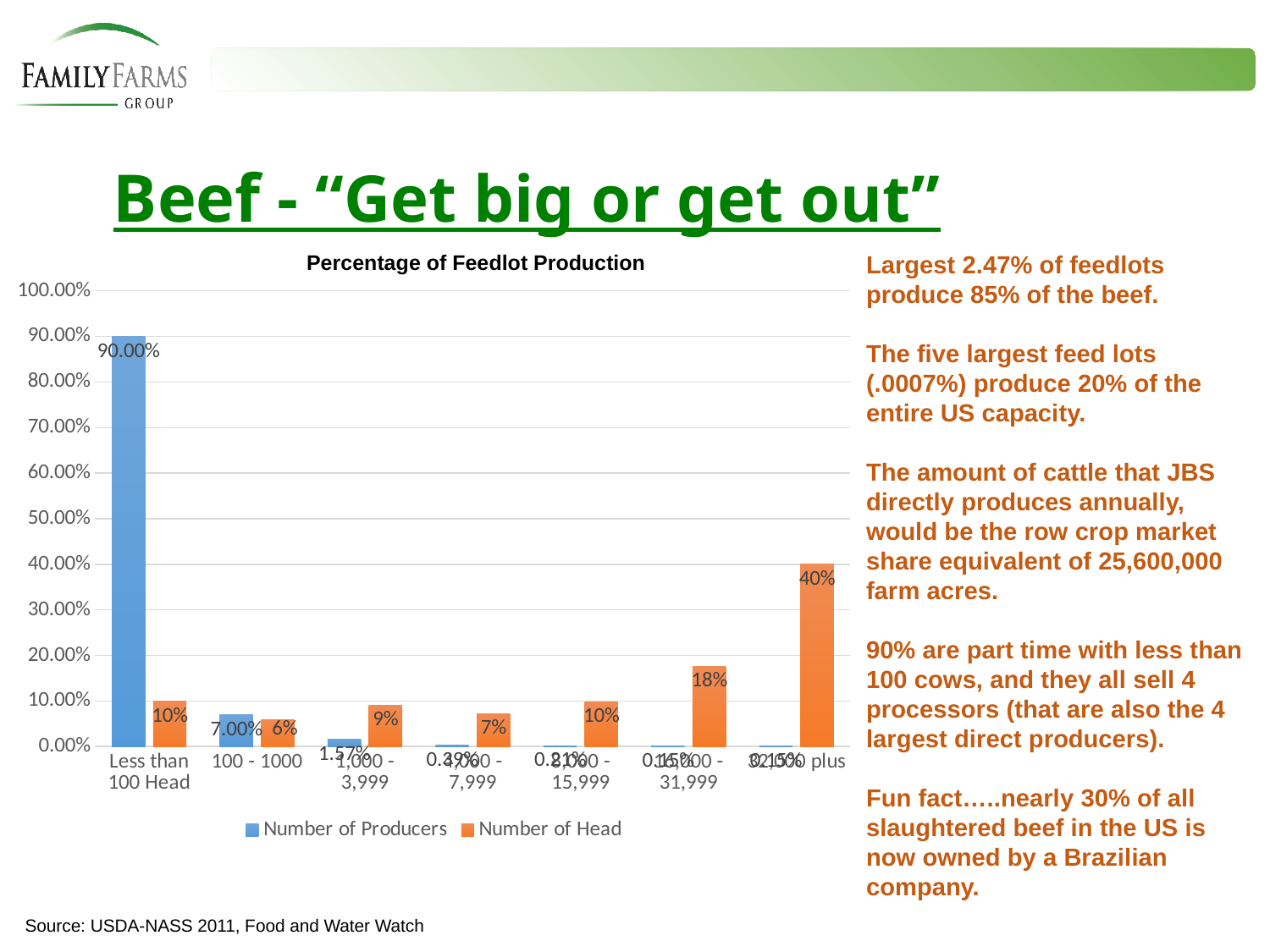
What is the difference between the Number of Head values for '32,000 plus' and '16,000 - 31,999'? 22% What is the Number of Producers value for the '1,000 - 3,999' category? 1.57% What is the Number of Producers value for the '100 - 1000' category? 7.00% Is the Number of Producers value for '32,000 plus' greater or less than 10.00%? less What is the Number of Head value for the '16,000 - 31,999' category? 18% What is the Number of Producers value for the 'Less than 100 Head' category? 90.00% What is the Number of Head value for the '32,000 plus' category? 40% How many series does the chart's legend list? 2 Which category has a larger Number of Head value: '1,000 - 3,999' or '4,000 - 7,999'? 1,000 - 3,999 How many categories are shown on the x axis of the chart? 7 Which category has the highest Number of Producers value? Less than 100 Head Which category has the highest Number of Head value? 32,000 plus